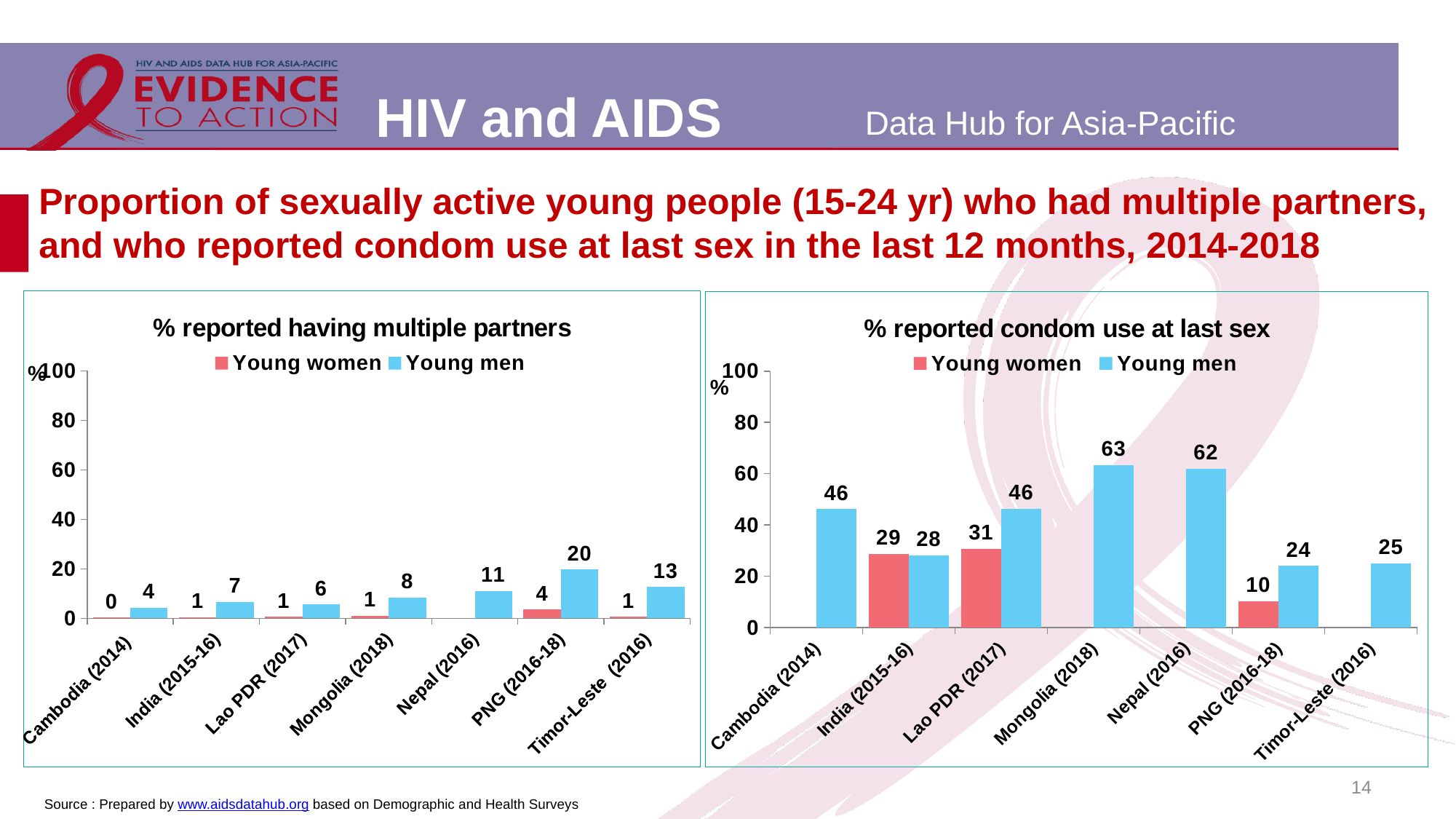
In the '% reported having multiple partners' chart, what is the value for young women in PNG (2016-18)? 4 In the '% reported having multiple partners' chart, which country has the highest value for young men? PNG (2016-18) In the '% reported condom use at last sex' chart, what is the value for young women in Lao PDR (2017)? 31 In the '% reported condom use at last sex' chart, what is the value for young men in Mongolia (2018)? 63 In the '% reported having multiple partners' chart, what is the value for young men in PNG (2016-18)? 20 In the '% reported condom use at last sex' chart, what is the difference between young men in Nepal (2016) and young men in PNG (2016-18)? 38 In the '% reported condom use at last sex' chart, which is larger: young women or young men in India (2015-16)? Young women What type of chart is the '% reported having multiple partners' chart? Bar chart How many countries are shown on the x axis of the '% reported condom use at last sex' chart? 7 In the '% reported condom use at last sex' chart, which country has the lowest value for young men? PNG (2016-18) In the '% reported having multiple partners' chart, which country has the lowest value for young men? Cambodia (2014) In the '% reported having multiple partners' chart, what is the difference between young men in Timor-Leste (2016) and young men in Mongolia (2018)? 5